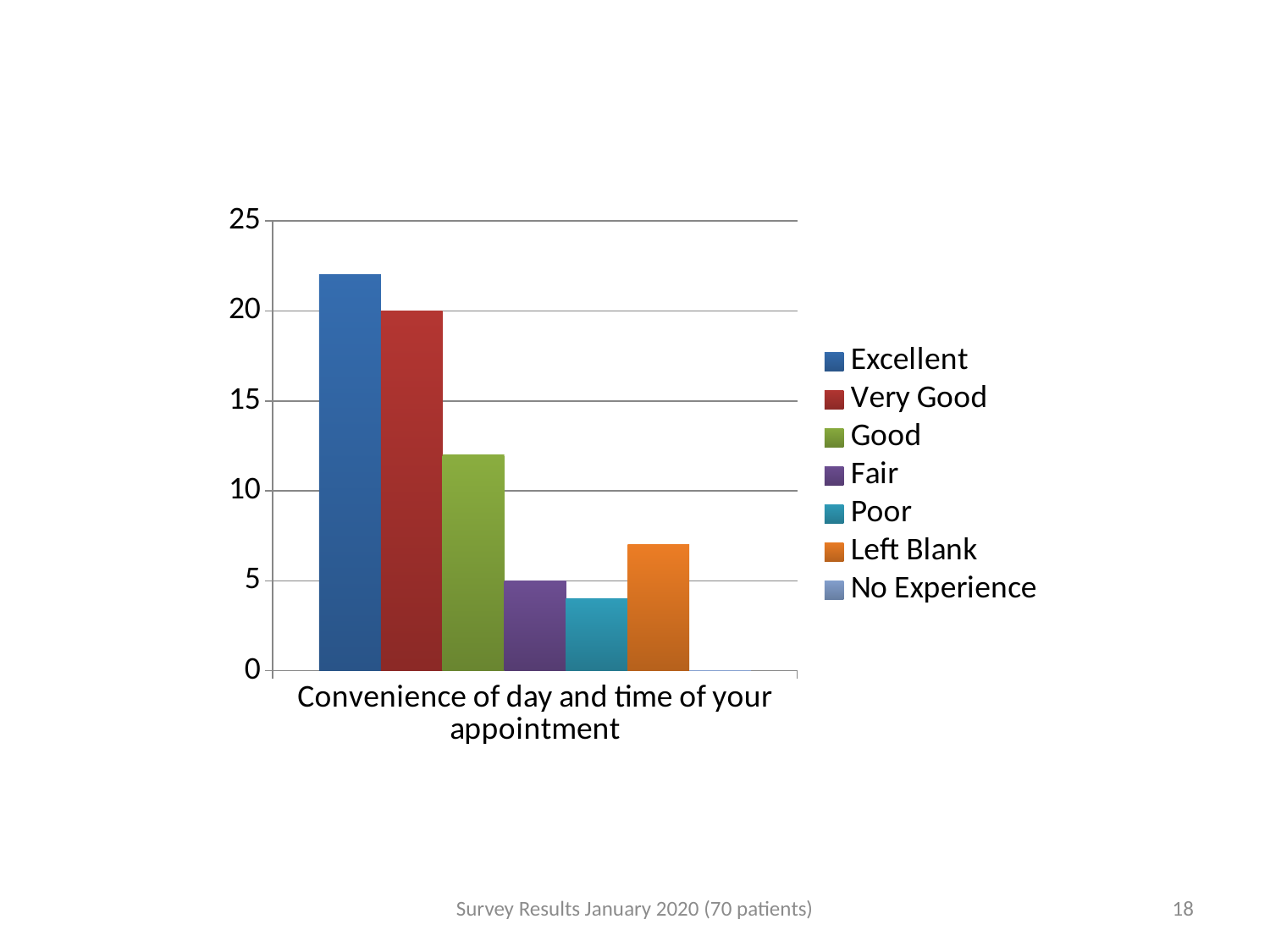
Which series has the highest value? Excellent What is the category label shown on the x axis? Convenience of day and time of your appointment How many series does the legend list? 7 Is the value for Excellent greater or less than 20? greater Is the value for Good greater or less than 10? greater What kind of chart is shown on the slide? bar chart What is the difference between the values for Very Good and Fair? 15 What is the value for Fair? 5 What is the value for Very Good? 20 Is the value for Poor greater or less than 5? less Which series has the lowest value? No Experience Which is larger, the value for Good or the value for Left Blank? Good